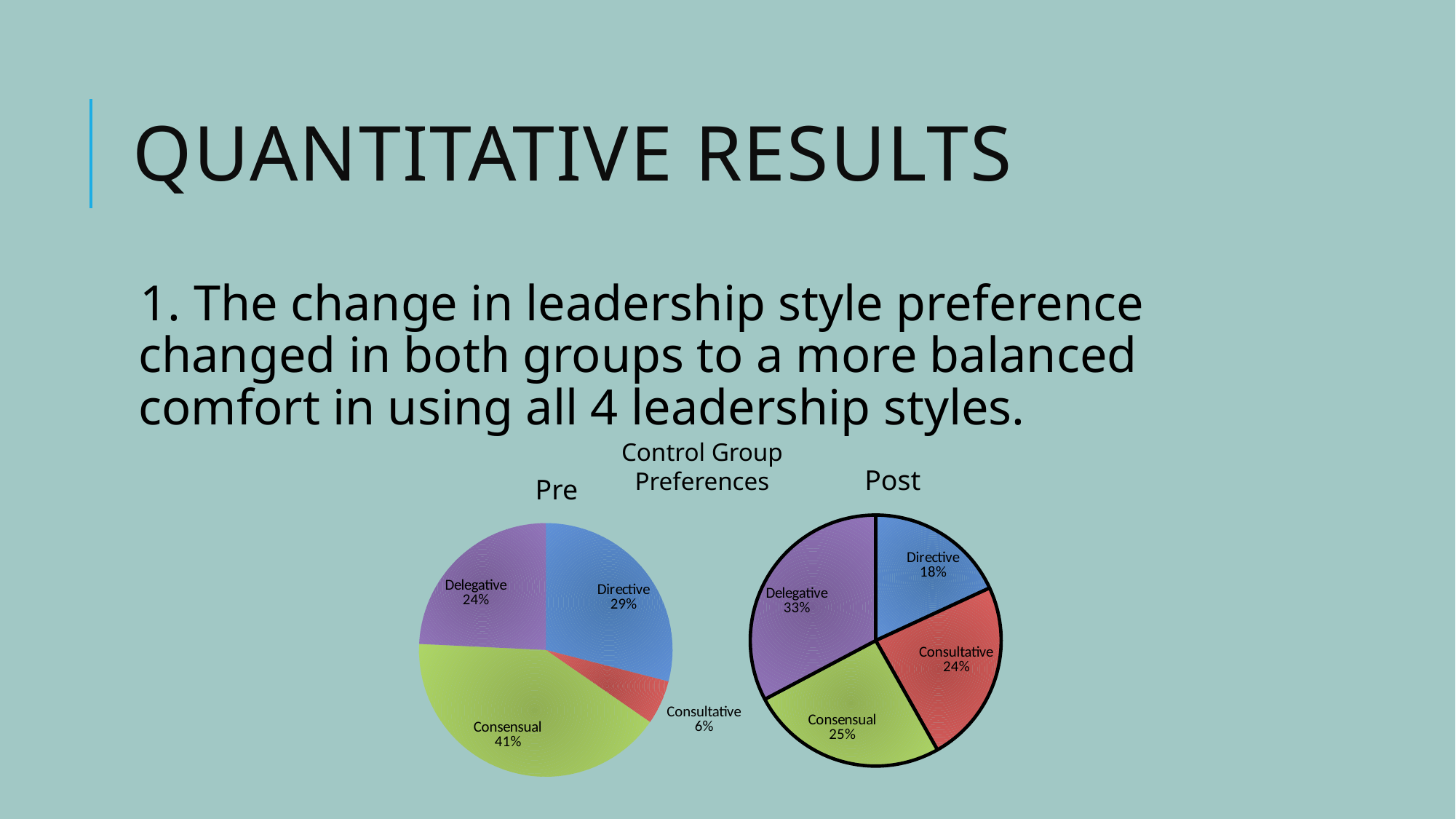
In the Pre pie chart, which category has the largest share? Consensual What type of chart is the Pre chart? Pie chart In the Post pie chart, which category has the largest share? Delegative In the Post pie chart, what share does Delegative have? 33% In the Pre pie chart, which is larger: Directive or Delegative? Directive In the Post pie chart, which category has the smallest share? Directive In the Pre pie chart, what share does Consensual have? 41% What is the title shown between the two pie charts? Control Group Preferences In the Pre pie chart, what share does Directive have? 29% How many categories does the Post pie chart show? 4 In the Pre pie chart, which category has the smallest share? Consultative What is the difference between the Consultative share in the Post chart and the Consultative share in the Pre chart? 18%